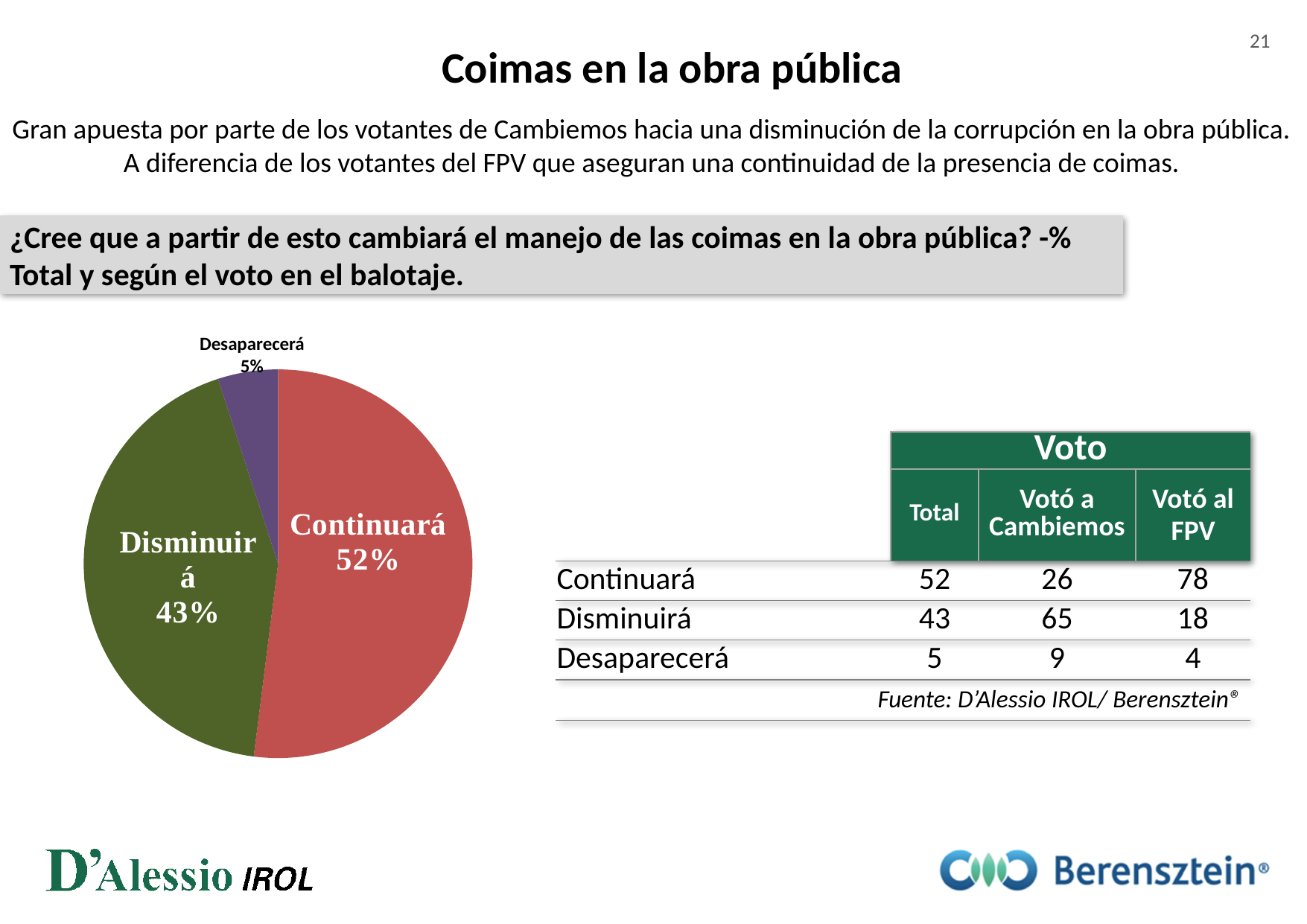
Which slice of the pie chart is the largest? Continuará What colour is the 'Disminuirá' slice in the pie chart? green Which slice of the pie chart is the smallest? Desaparecerá What is the value shown for 'Desaparecerá' in the pie chart? 5% What kind of chart is shown on the slide? pie chart What is the difference in percentage points between the 'Continuará' and 'Disminuirá' slices? 9 What colour is the 'Continuará' slice in the pie chart? red How many slices does the pie chart have? 3 Which is larger in the pie chart, 'Disminuirá' or 'Desaparecerá'? Disminuirá What is the value shown for 'Disminuirá' in the pie chart? 43% What share of the pie does the 'Continuará' slice represent? 52%